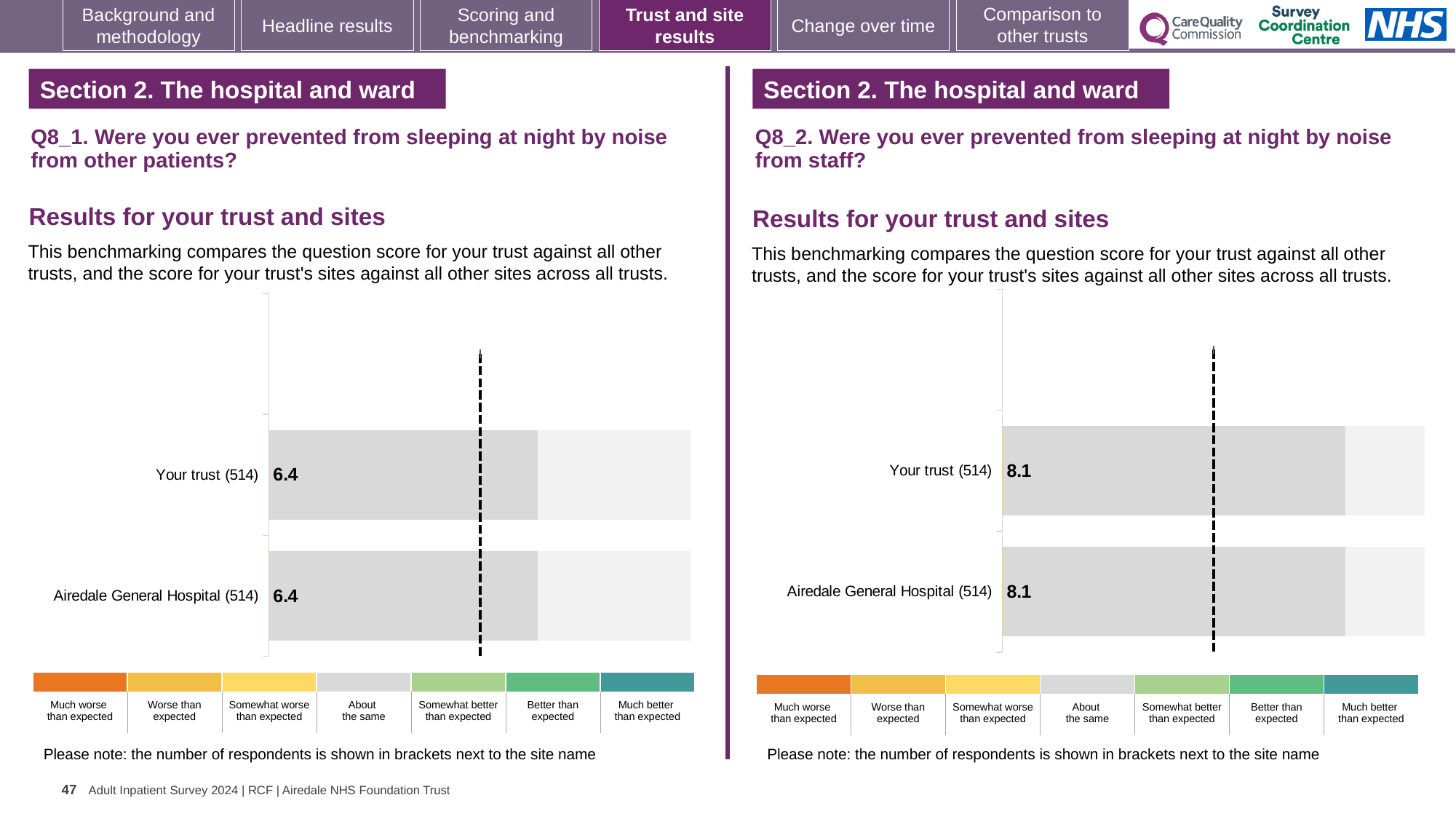
On the left chart (Q8_1), how many respondents are shown in brackets next to Airedale General Hospital? 514 On the left chart (Q8_1), what is the difference between the score for Your trust and the score for Airedale General Hospital? 0 On the right chart (Q8_2, noise from staff), what is the score for Airedale General Hospital? 8.1 On the left chart (Q8_1, noise from other patients), what is the score for Your trust? 6.4 What kind of chart is used on the left (Q8_1) to show the results for your trust and sites? Bar chart How many bars are plotted on the left chart (Q8_1)? 2 On the right chart (Q8_2, noise from staff), what is the score for Your trust? 8.1 On the left chart (Q8_1, noise from other patients), what is the score for Airedale General Hospital? 6.4 How many benchmark categories does the colour key below the right chart (Q8_2) list? 7 In the colour key below the left chart (Q8_1), which category is shown in grey? About the same How many bars are plotted on the right chart (Q8_2)? 2 On the right chart (Q8_2), what is the difference between the score for Your trust and the score for Airedale General Hospital? 0